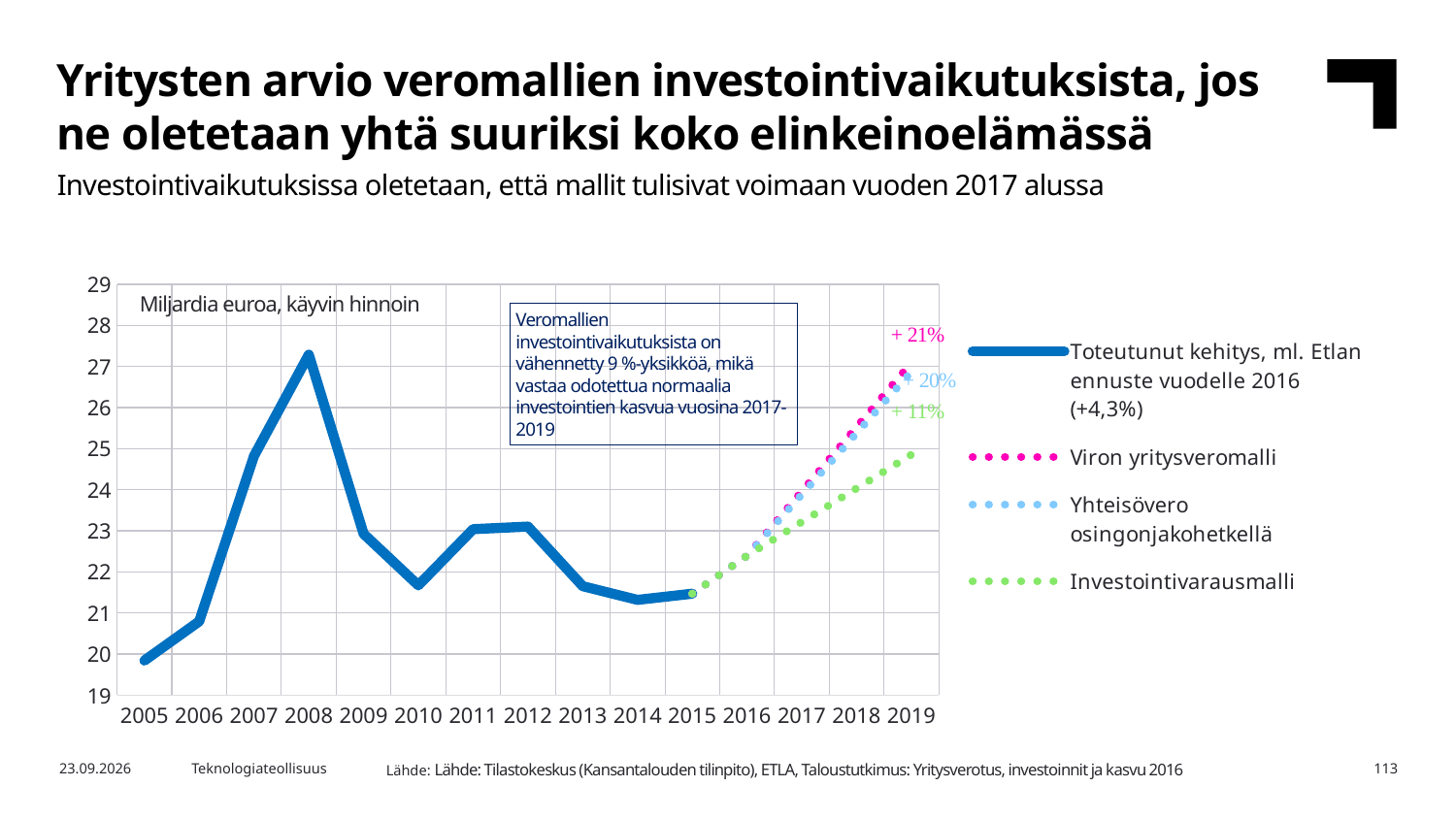
How many years are shown on the x axis? 15 In which year does the Toteutunut kehitys line reach its highest value? 2008 What kind of chart is shown on the slide? line chart Does the Toteutunut kehitys line rise or fall from 2008 to 2009? fall Is the Investointivarausmalli value for 2019 greater or less than 26? less How many series does the legend list? 4 Is the Toteutunut kehitys value for 2014 greater or less than 22? less What percentage increase is labelled for the Viron yritysveromalli series? + 21% In which year is the Toteutunut kehitys line at its lowest value? 2005 Which projected series ends lowest in 2019? Investointivarausmalli Is the Toteutunut kehitys value for 2008 greater or less than 26? greater Which is larger for Toteutunut kehitys: the value in 2008 or the value in 2011? 2008